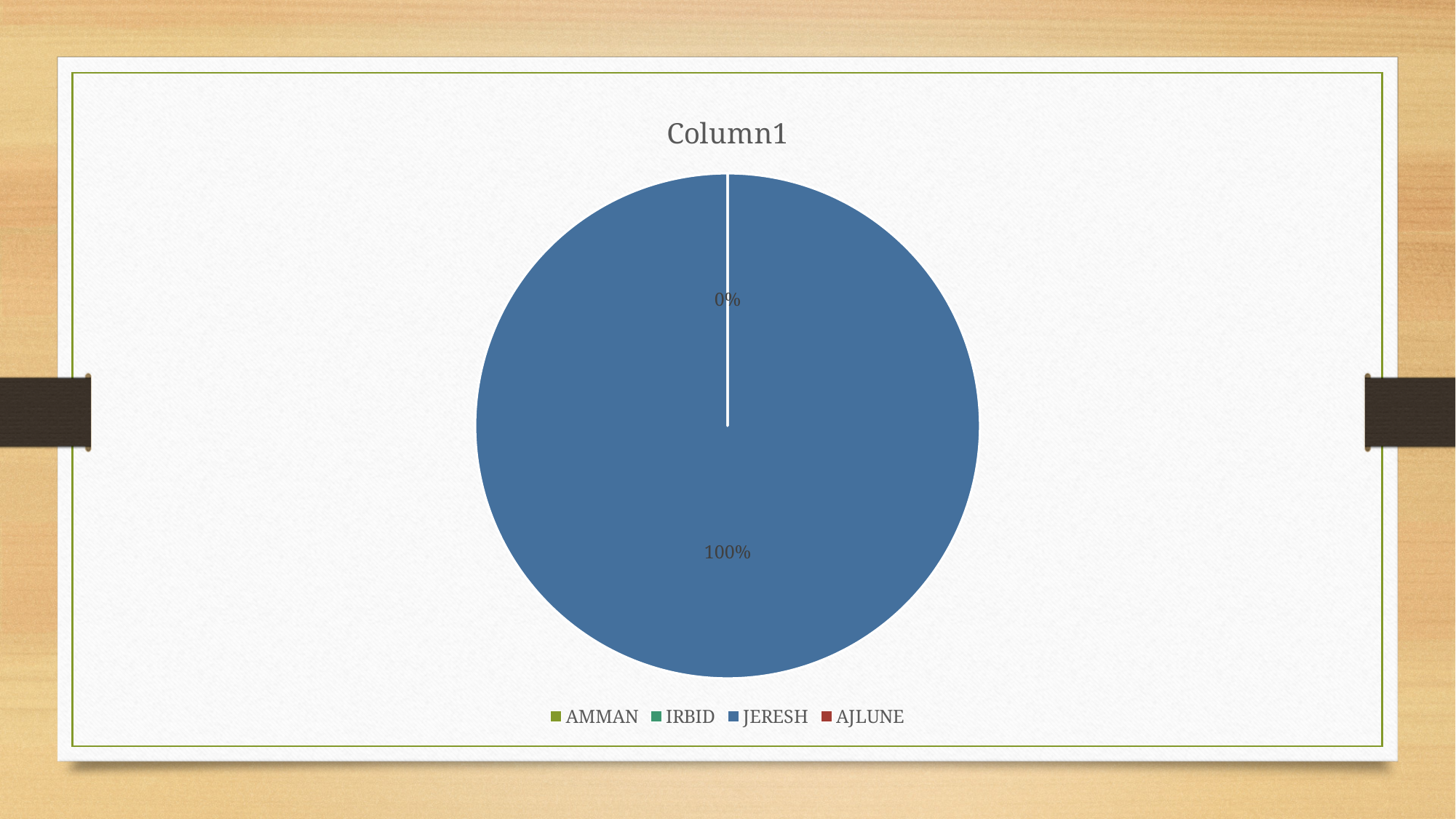
Which category is larger, JERESH or AMMAN? JERESH Which category has the largest share of the pie? JERESH What colour is the JERESH slice in the legend? blue What kind of chart is shown on the slide? pie chart Which category is larger, JERESH or AJLUNE? JERESH Which category is larger, JERESH or IRBID? JERESH What is the title of the chart? Column1 What share of the pie does JERESH take? 100% Is the share for JERESH greater or less than 50%? greater How many categories does the legend list? 4